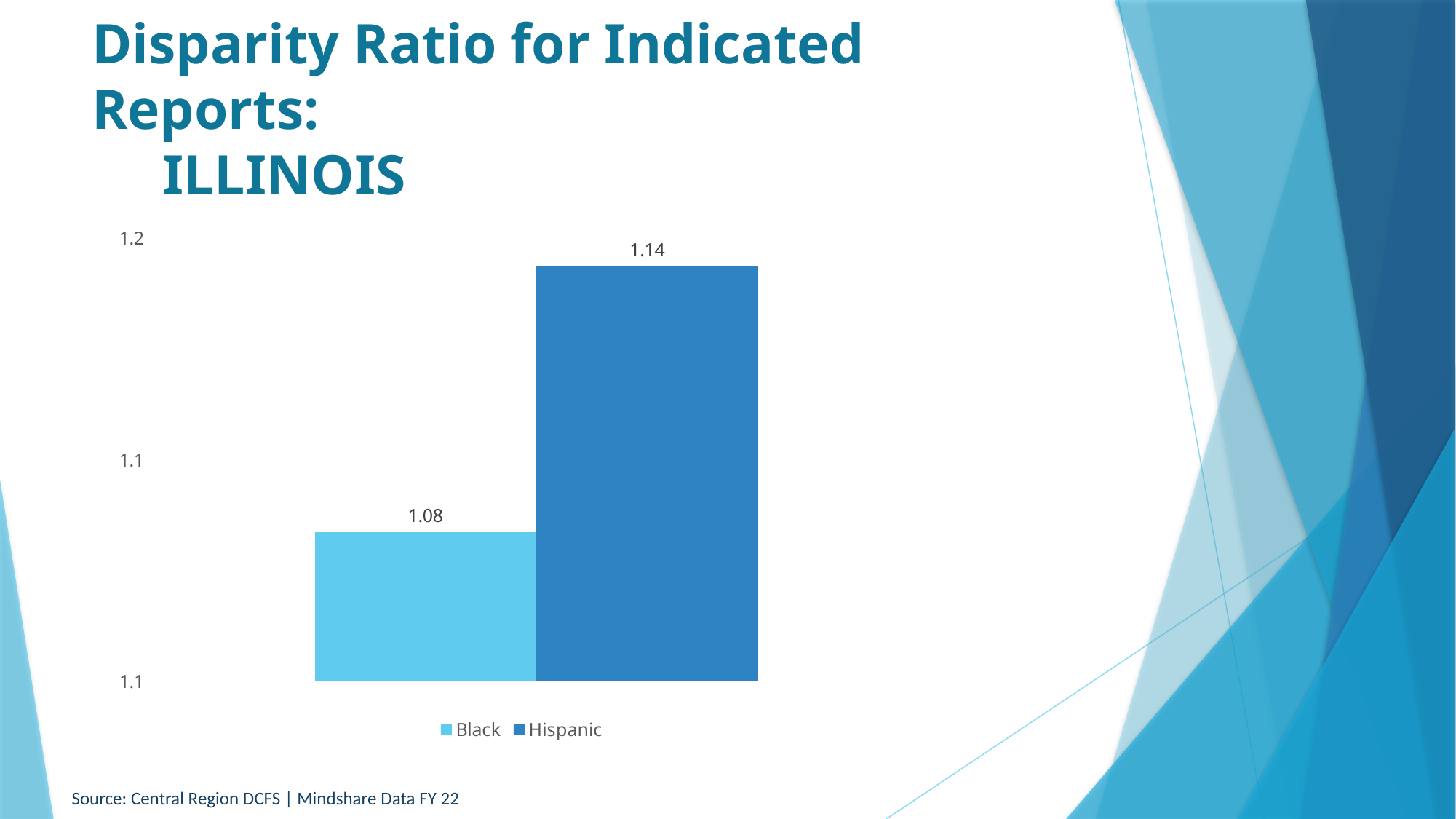
How many entries does the legend list? 2 Which group has the lower disparity ratio? Black Is the value for Black greater or less than 1.1? less What is the difference between the Hispanic and Black disparity ratios? 0.06 What is the disparity ratio for Hispanic? 1.14 What is the disparity ratio for Black? 1.08 Is the disparity ratio for Black larger or smaller than the ratio for Hispanic? smaller What kind of chart is shown on the slide? bar chart How many bars are plotted in the chart? 2 Is the value for Hispanic greater or less than 1.1? greater What is the title of the slide? Disparity Ratio for Indicated Reports: ILLINOIS Which group has the higher disparity ratio? Hispanic